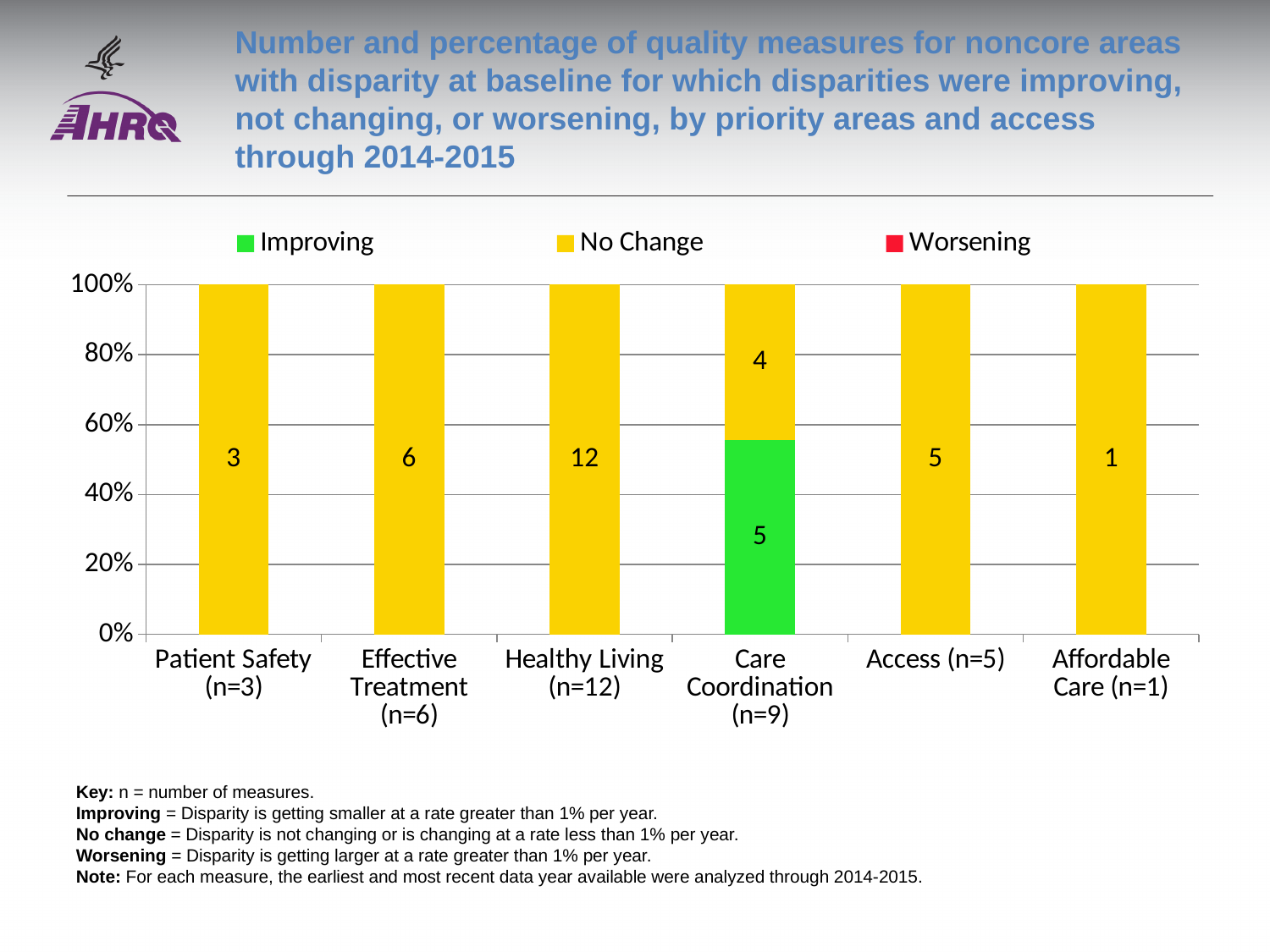
What is the Improving value for Care Coordination (n=9)? 5 What is the No Change value for Care Coordination (n=9)? 4 Which is larger, the Improving value or the No Change value for Care Coordination (n=9)? Improving What is the No Change value for Affordable Care (n=1)? 1 Which category has the lowest No Change value? Affordable Care (n=1) Which category has the highest No Change value? Healthy Living (n=12) How many series does the legend list? 3 What kind of chart is shown? Stacked bar chart What is the difference between the No Change values for Healthy Living (n=12) and Effective Treatment (n=6)? 6 What is the total of the Care Coordination (n=9) bar? 9 How many categories are shown on the x axis? 6 What is the No Change value for Healthy Living (n=12)? 12